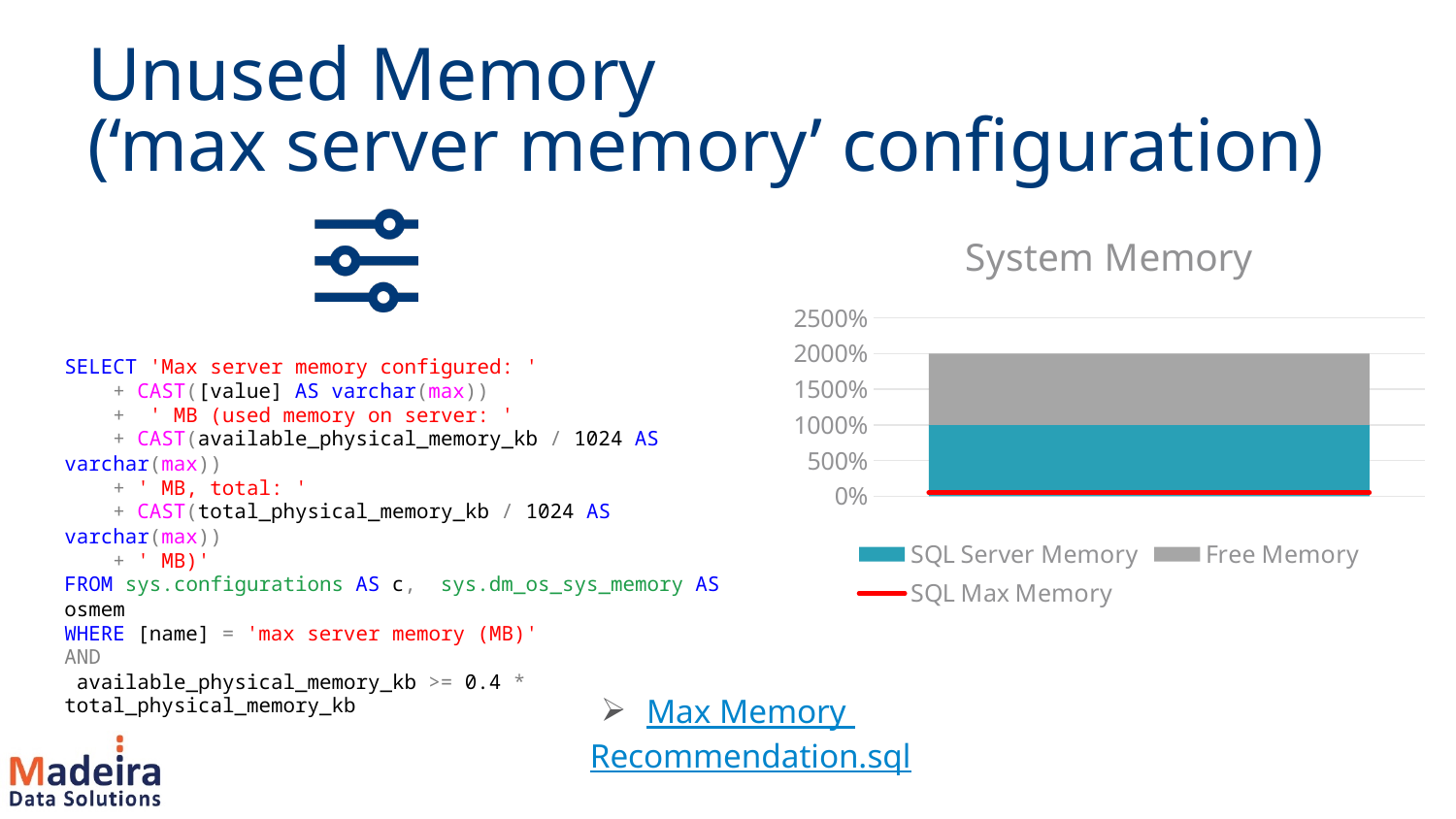
What is the total height of the stacked bar (SQL Server Memory plus Free Memory)? 2000% At what y-axis value does the SQL Max Memory line sit? 0% Is the value for SQL Server Memory greater or less than 500%? greater What type of chart is shown on the slide? area and line chart How many series does the chart legend list? 3 Is the top of the stacked bar greater or less than 1500%? greater Which is larger in the chart: the SQL Server Memory segment or the SQL Max Memory line value? SQL Server Memory What value does the SQL Server Memory segment reach on the y axis? 1000% What is the highest value shown on the y axis of the chart? 2500% What is the title of the chart? System Memory